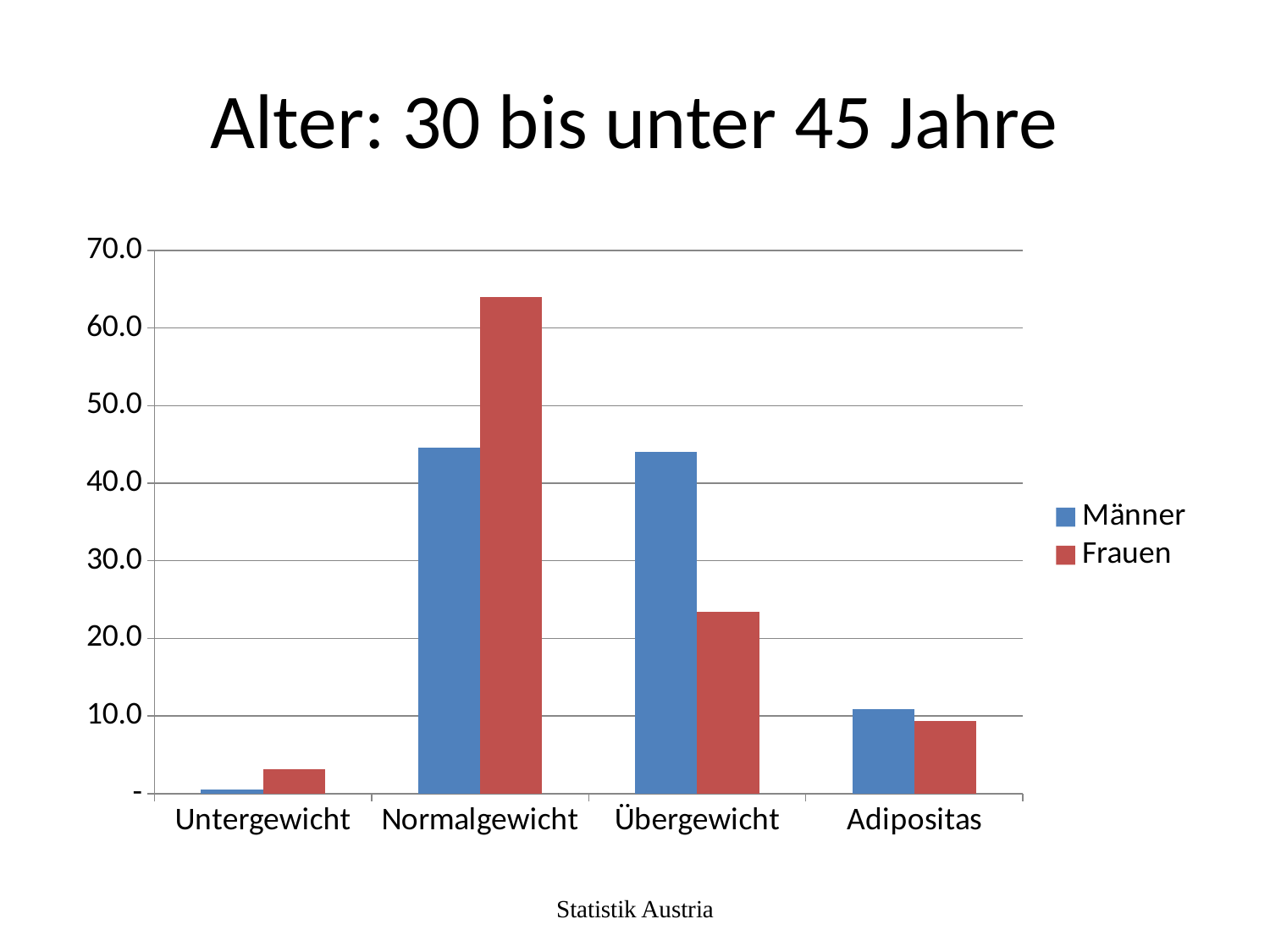
What is the title of the slide containing the chart? Alter: 30 bis unter 45 Jahre Which category has the lowest value for Frauen? Untergewicht How many categories are shown on the x axis? 4 For Übergewicht, which is larger: Männer or Frauen? Männer Is the value for Frauen in Normalgewicht greater or less than 60.0? greater For Normalgewicht, which is larger: Männer or Frauen? Frauen What kind of chart is shown on the slide? bar chart Which category has the highest value for Frauen? Normalgewicht How many series does the legend list? 2 Which category has the lowest value for Männer? Untergewicht Is the value for Frauen in Übergewicht greater or less than 30.0? less Which series is shown in red? Frauen